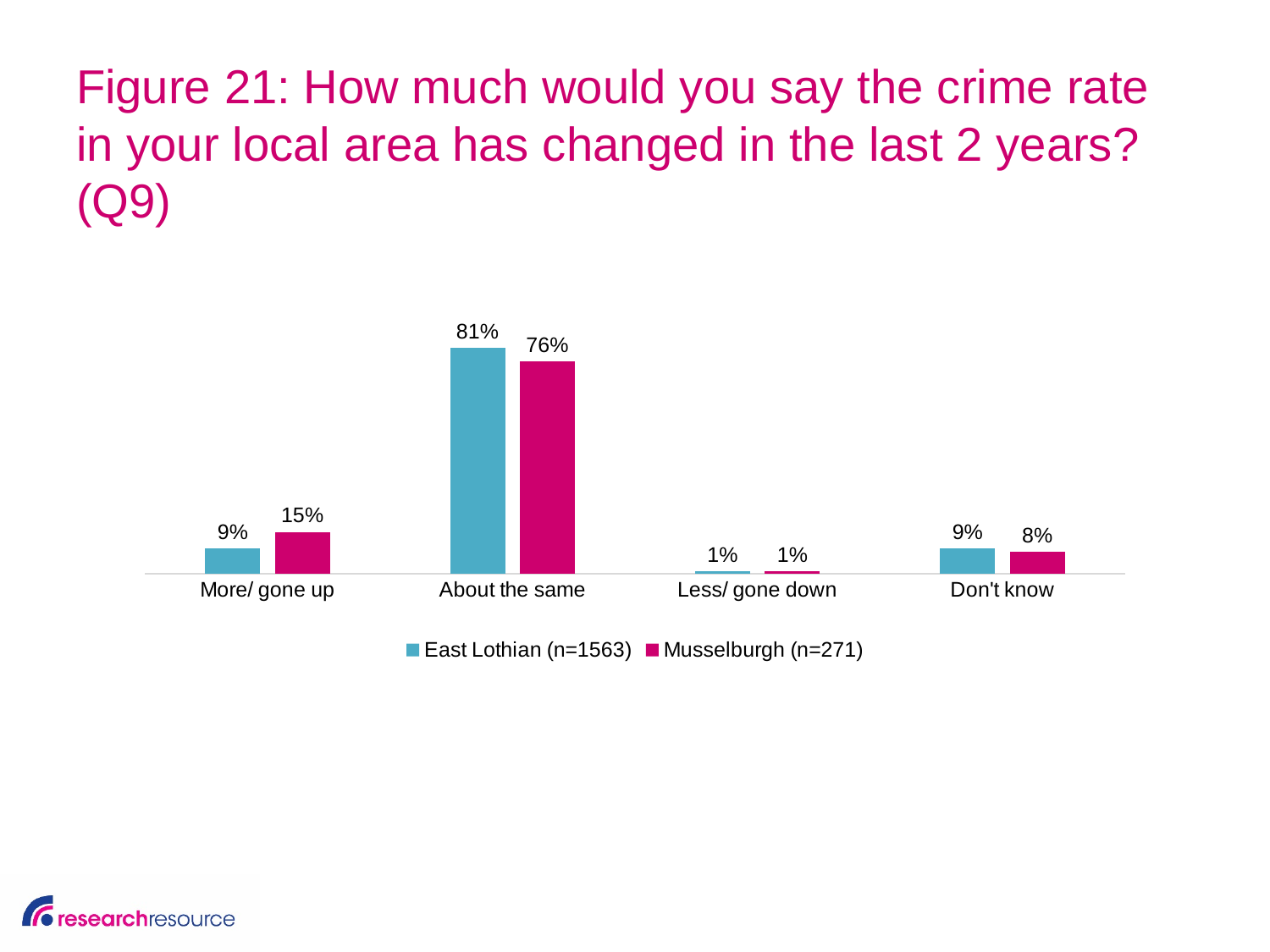
Which category has the lowest value for Musselburgh? Less/ gone down What type of chart is shown on the slide? Bar chart Which category has the highest value for East Lothian? About the same What percentage of East Lothian respondents said the crime rate has stayed about the same? 81% What is the difference between the East Lothian and Musselburgh values for 'About the same'? 5 percentage points How many series does the legend list? 2 How many response categories are shown on the x axis? 4 What is the value for Musselburgh in the 'Don't know' category? 8% What is the sample size for Musselburgh shown in the legend? n=271 What percentage of Musselburgh respondents said the crime rate has gone up? 15% What is the difference between the Musselburgh and East Lothian values for 'More/ gone up'? 6 percentage points Which series has the larger value for 'More/ gone up', East Lothian or Musselburgh? Musselburgh